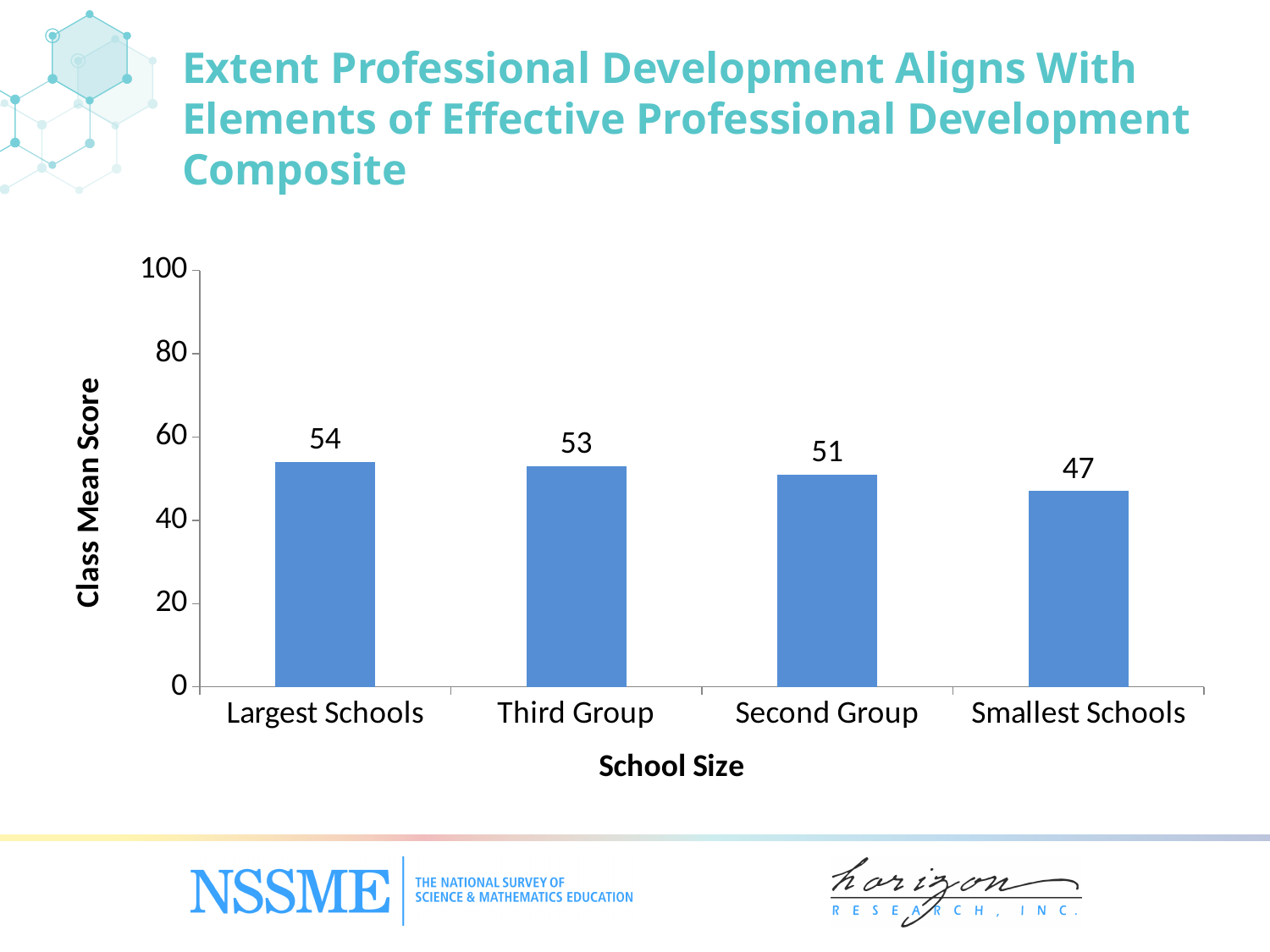
What is the class mean score for Largest Schools? 54 How many school size groups are shown on the chart? 4 What is the class mean score for Second Group? 51 Which school size group has the lowest class mean score? Smallest Schools What is the difference between the class mean scores for Largest Schools and Smallest Schools? 7 Do the class mean scores rise or fall from Largest Schools to Smallest Schools along the x axis? fall What is the difference between the class mean scores for Third Group and Second Group? 2 Is the class mean score for Third Group greater or less than 60? less What is the class mean score for Smallest Schools? 47 What kind of chart is shown on the slide? bar chart Which school size group has the highest class mean score? Largest Schools Which has a higher class mean score, Second Group or Smallest Schools? Second Group